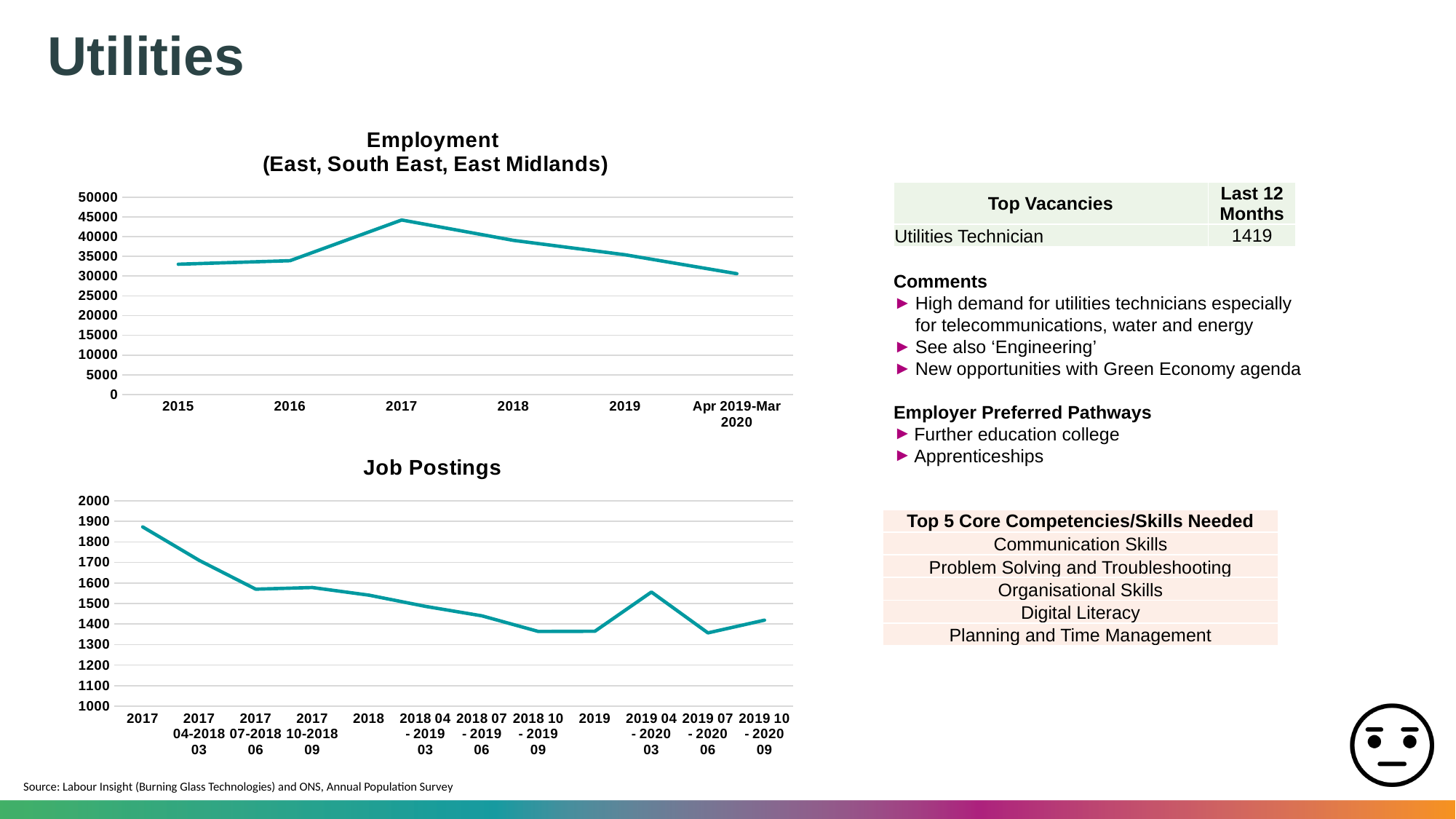
In the Job Postings chart, do the values generally rise or fall from 2017 to 2018 10 - 2019 09? fall In the Job Postings chart, is the value for 2017 greater or less than 1800? greater In the Employment (East, South East, East Midlands) chart, is the value for 2015 greater or less than 35000? less In the Job Postings chart, which period has the highest number of job postings? 2017 In the Employment (East, South East, East Midlands) chart, which period has the lowest employment? Apr 2019-Mar 2020 How many data points are plotted in the Job Postings chart? 12 In the Employment (East, South East, East Midlands) chart, is the value for 2017 greater or less than 40000? greater In the Employment (East, South East, East Midlands) chart, which year has the highest employment? 2017 What kind of chart is the Employment (East, South East, East Midlands) chart? line chart How many data points are plotted in the Employment (East, South East, East Midlands) chart? 6 In the Employment (East, South East, East Midlands) chart, which is larger, the value for 2018 or the value for 2019? 2018